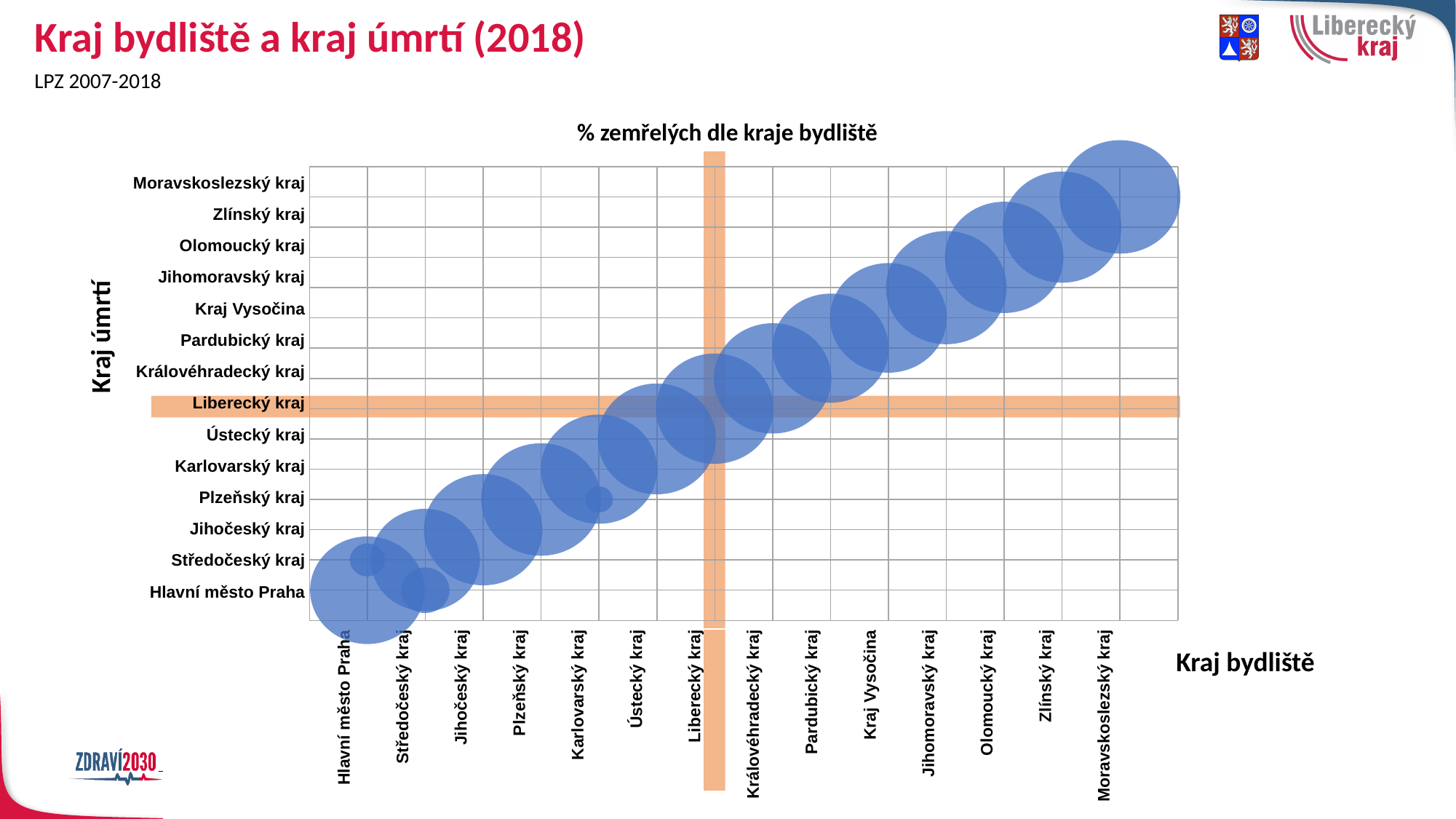
How many regions are listed along the y axis (Kraj úmrtí) of the chart? 14 Which region is the topmost category on the y axis of the chart? Moravskoslezský kraj Which region is the first category on the x axis of the chart? Hlavní město Praha What kind of chart is shown on the slide? bubble chart How many regions are listed along the x axis (Kraj bydliště) of the chart? 14 Which region is the last category on the x axis of the chart? Moravskoslezský kraj Which region is the bottom category on the y axis of the chart? Hlavní město Praha Which region is highlighted with orange bands on both axes of the chart? Liberecký kraj What is the title of the chart? % zemřelých dle kraje bydliště